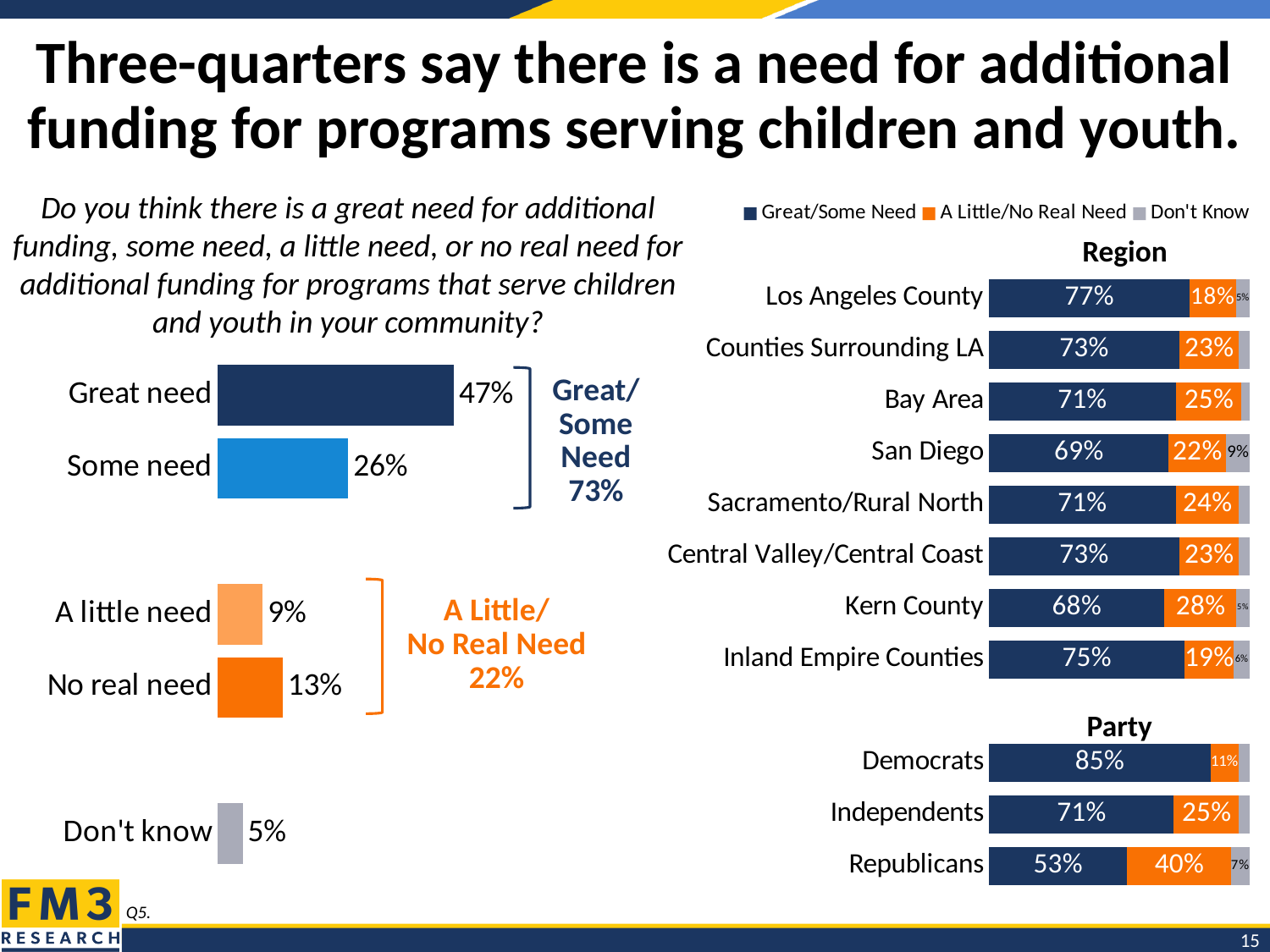
In the right chart, what percentage of Kern County respondents say there is A Little/No Real Need? 28% What type of chart is the left chart showing the overall responses? Bar chart In the left chart, what percentage of respondents said there is no real need? 13% How many series does the legend of the right chart list? 3 In the right chart, which group has a larger Great/Some Need percentage, Republicans or Independents? Independents In the left chart, which response category has the lowest percentage? Don't know In the right chart, what percentage of Democrats say there is a Great/Some Need? 85% In the left chart, how many percentage points higher is 'Great need' than 'Some need'? 21 percentage points In the left chart, which response category has the highest percentage? Great need In the right chart, how many regions are listed under the Region heading? 8 In the right chart, which region has the highest Great/Some Need percentage? Los Angeles County In the left chart, what percentage of respondents said there is a great need for additional funding? 47%